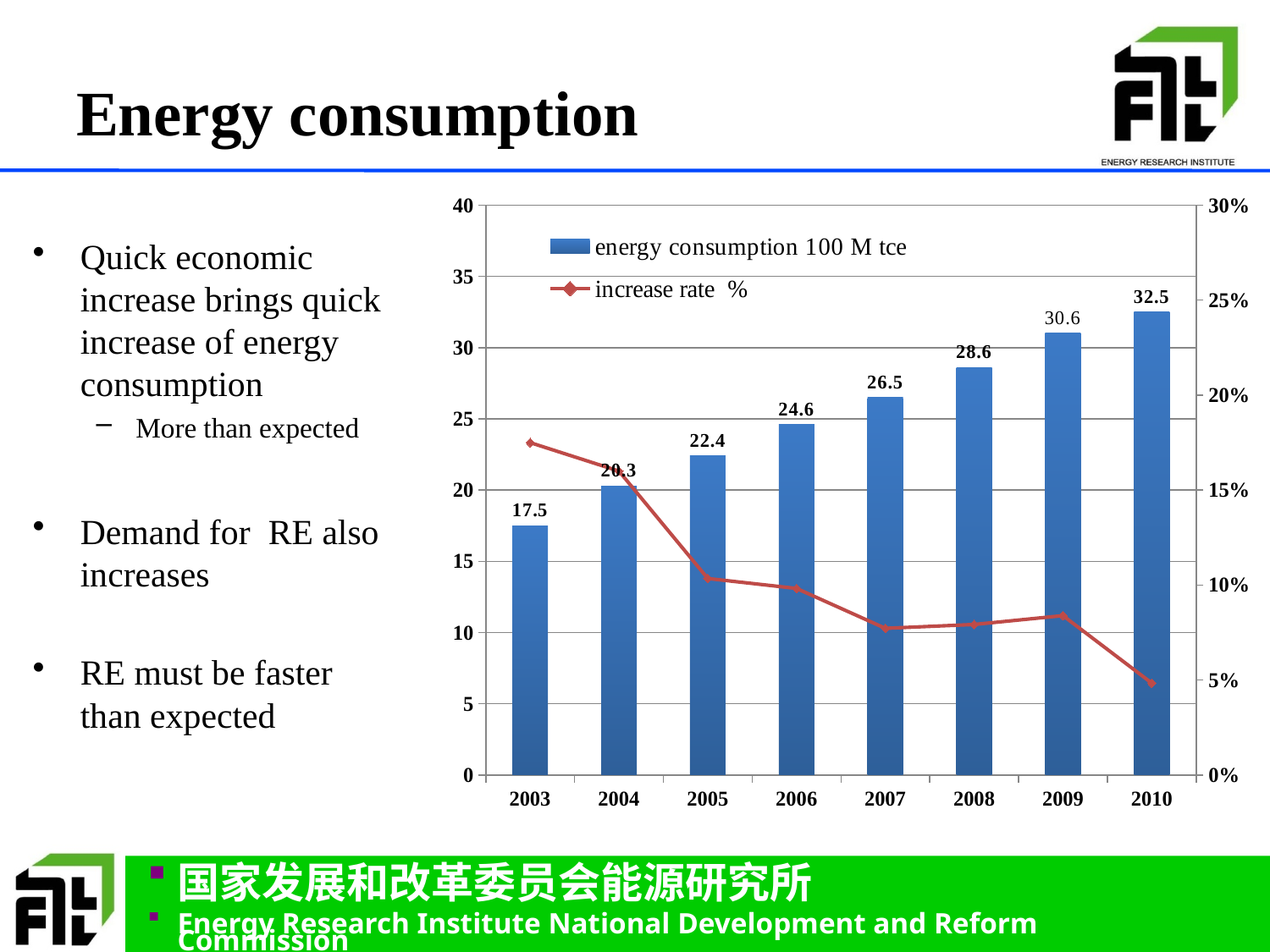
Is the increase rate for 2010 greater or less than 10%? less What is the energy consumption value for 2007? 26.5 How many years are shown on the x axis? 8 Which year has the larger energy consumption, 2005 or 2006? 2006 Which year has the lowest energy consumption? 2003 What is the energy consumption value for 2003? 17.5 What is the difference in energy consumption between 2010 and 2003? 15 Is the increase rate for 2003 greater or less than 15%? greater What is the difference in energy consumption between 2009 and 2008? 2 Does the increase rate line generally rise or fall from 2003 to 2010? fall How many series does the legend list? 2 Which year has the highest energy consumption? 2010